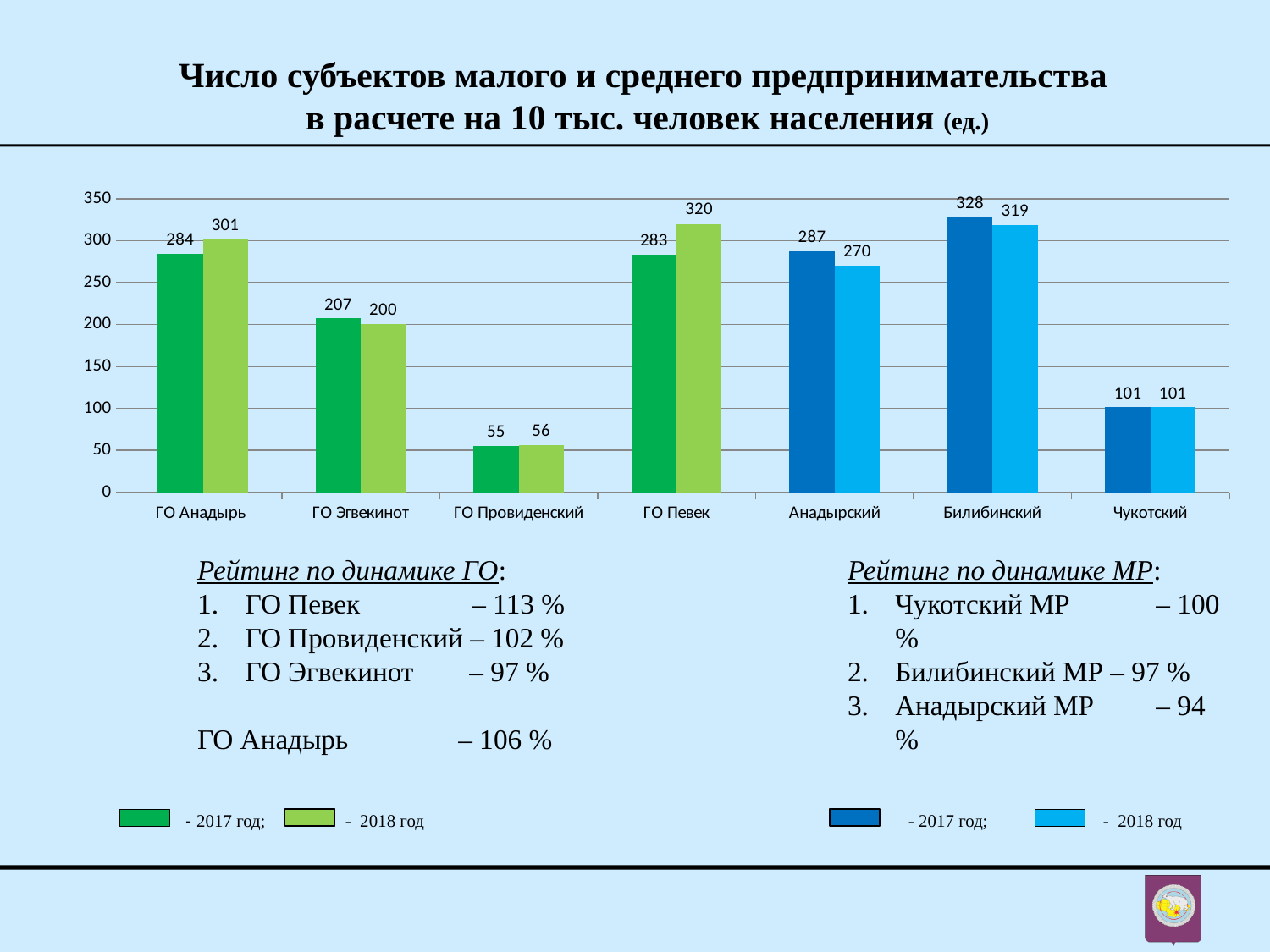
Which two years are compared in the chart's legend? 2017 and 2018 What kind of chart is shown on the slide? bar chart Which category has the highest 2017 value? Билибинский What is the difference between the 2017 and 2018 values for Анадырский? 17 What is the 2018 value for Анадырский? 270 What is the 2017 value for Билибинский? 328 How many categories are shown on the x axis of the chart? 7 Which category has the lowest 2018 value? ГО Провиденский Which is larger for ГО Эгвекинот: the 2017 value or the 2018 value? 2017 Is the 2018 value for ГО Анадырь greater or less than 250? greater What is the 2018 value for ГО Певек? 320 What is the difference between the 2018 and 2017 values for ГО Певек? 37